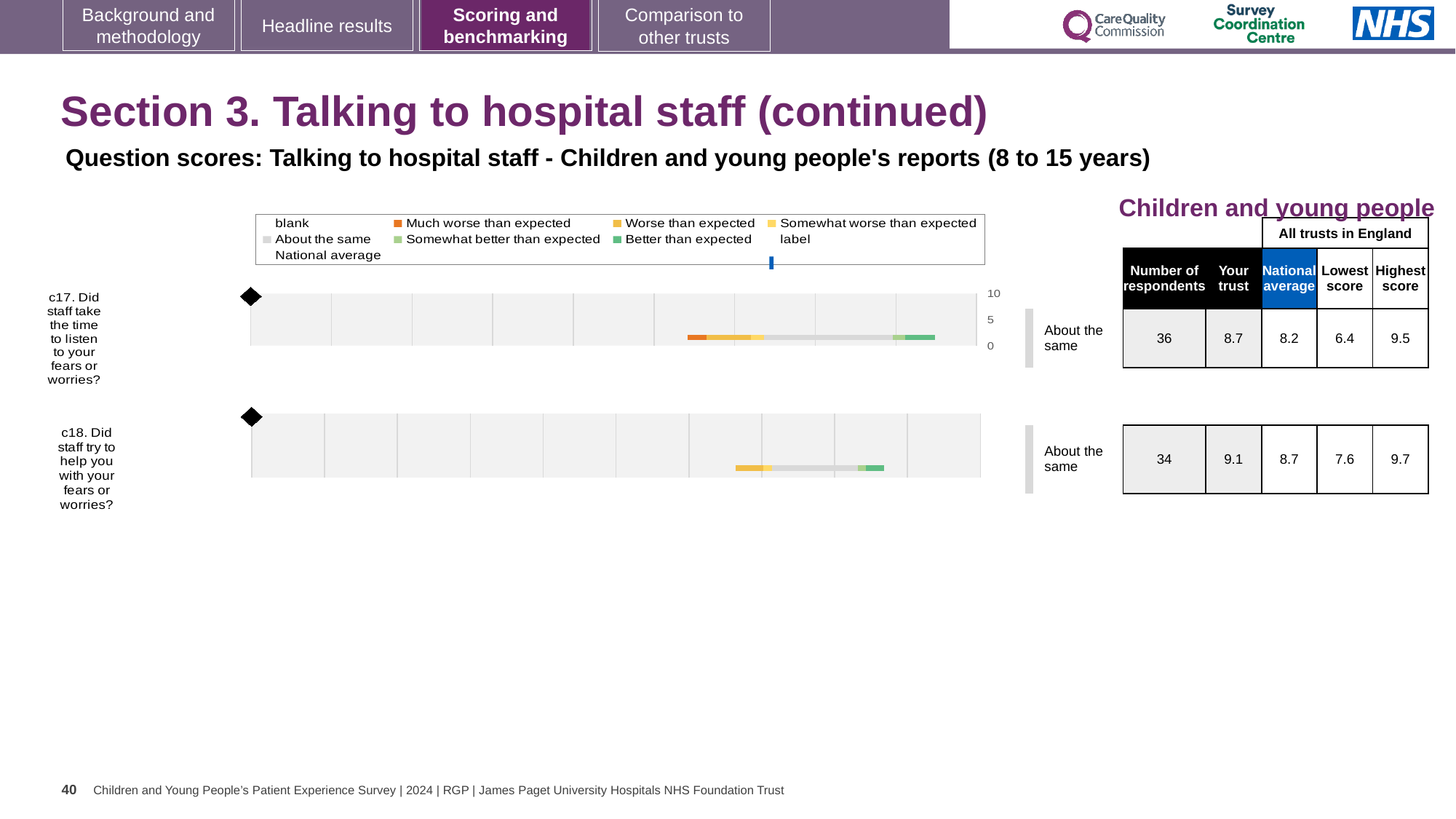
What is the National average score for question c18? 8.7 For question c17 (Did staff take the time to listen to your fears or worries?), what is the score for Your trust? 8.7 What benchmark category is shown for question c17? About the same For question c18, what is the difference between the Highest score and the Lowest score? 2.1 How many respondents are shown for question c17? 36 For question c17, what is the difference between the Your trust score and the National average? 0.5 For question c18 (Did staff try to help you with your fears or worries?), what is the score for Your trust? 9.1 How many questions are charted on this slide? 2 What is the National average score for question c17? 8.2 What is the Lowest score among all trusts in England for question c18? 7.6 Which question has the higher Your trust score, c17 or c18? c18 What is the Highest score among all trusts in England for question c17? 9.5